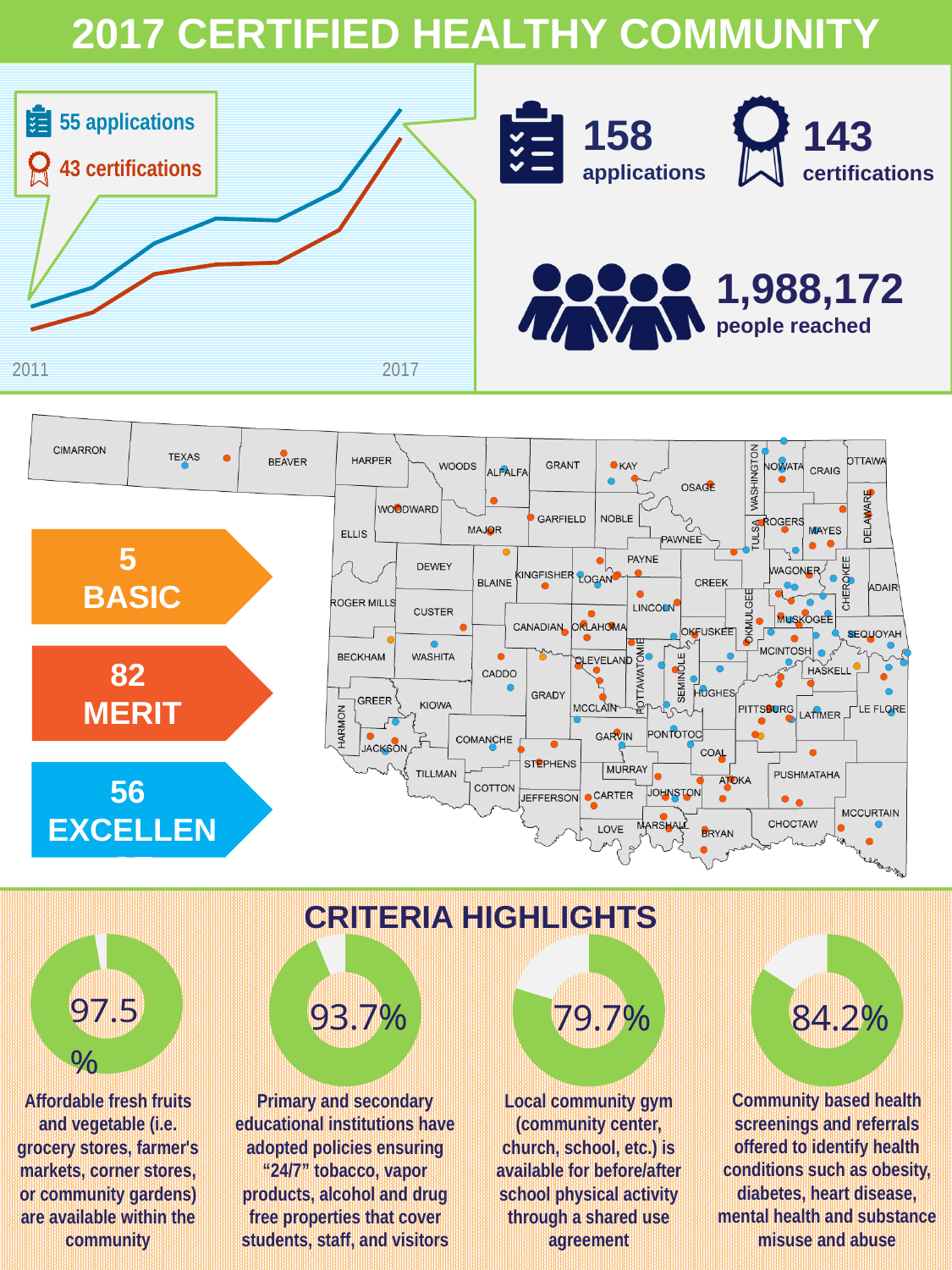
In the Criteria Highlights donut charts, what percentage is shown for a local community gym being available for before/after school physical activity? 79.7% In the top-left line chart, by how much did applications increase from 2011 to 2017? 103 Among the four Criteria Highlights donut charts, which criterion has the lowest percentage? Local community gym available for before/after school physical activity In the top-left line chart, do the applications and certifications lines rise or fall from 2011 to 2017? rise In the top-left line chart, how many applications were there in 2011? 55 In the top-left line chart, how many certifications were there in 2017? 143 In the top-left line chart, how many applications were there in 2017? 158 In the Criteria Highlights donut charts, what percentage is shown for affordable fresh fruits and vegetables being available within the community? 97.5% In the top-left line chart, how many certifications were there in 2011? 43 How many donut charts are shown in the Criteria Highlights section? 4 What kind of chart is shown in the top-left panel covering 2011 to 2017? line chart In the top-left line chart, which line is higher in 2017, applications or certifications? applications